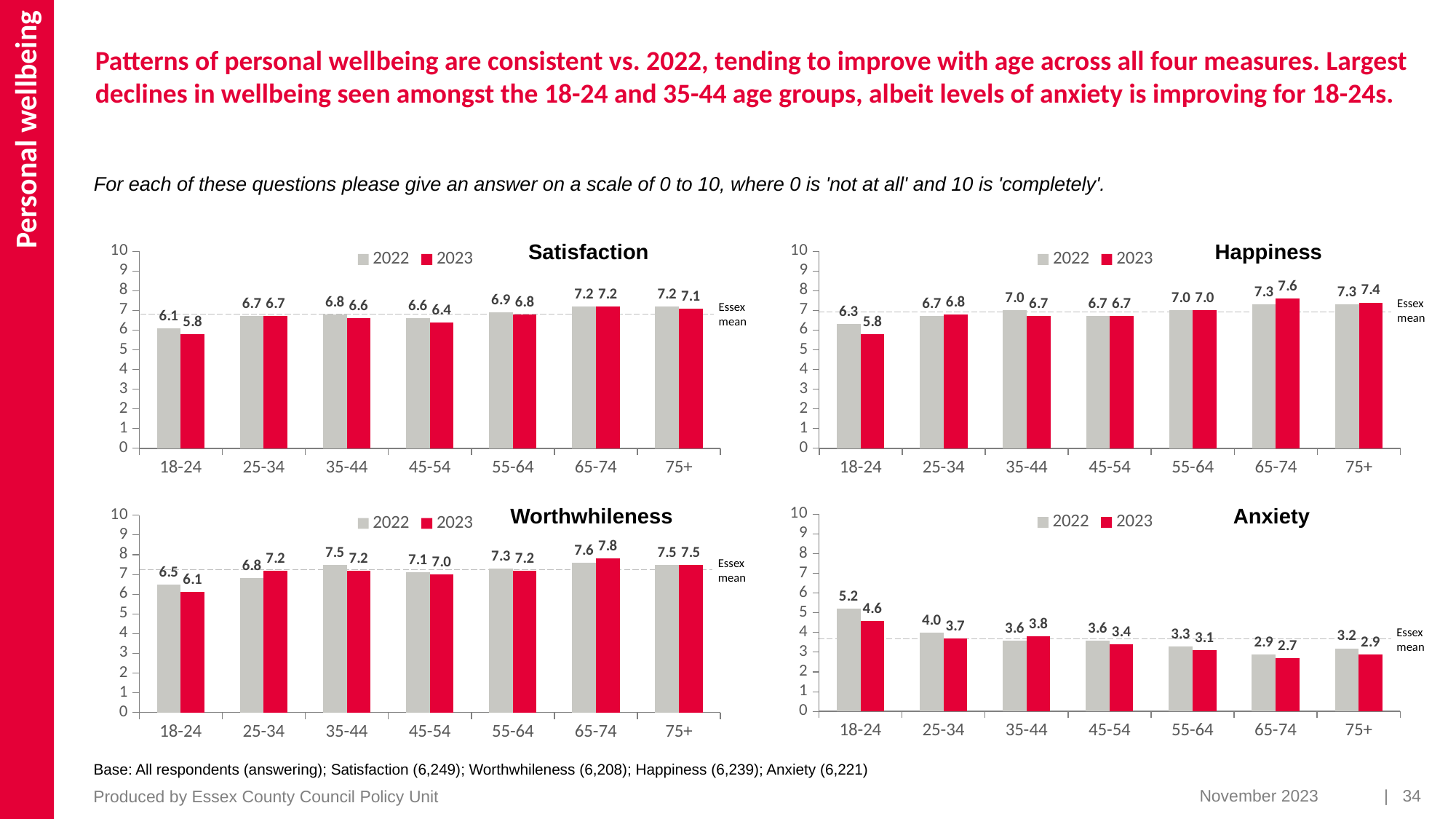
In the Worthwhileness chart, what is the 2023 value for the 65-74 age group? 7.8 What type of chart is the Anxiety chart? Bar chart In the Anxiety chart, do the 2022 values generally rise or fall from the 18-24 group to the 65-74 group? Fall In the Anxiety chart, which age group has the highest 2023 value? 18-24 In the Happiness chart, what is the 2022 value for the 35-44 age group? 7.0 In the Satisfaction chart, how many series does the legend list? 2 In the Happiness chart, what is the difference between the 2022 and 2023 values for the 18-24 age group? 0.5 In the Worthwhileness chart, which age group has the lowest 2022 value? 18-24 In the Satisfaction chart, what is the 2023 value for the 18-24 age group? 5.8 Which colour represents the 2023 series in the charts? Red In the Anxiety chart, which is larger for the 35-44 age group: the 2022 value or the 2023 value? 2023 In the Worthwhileness chart, how many age groups are shown on the x axis? 7